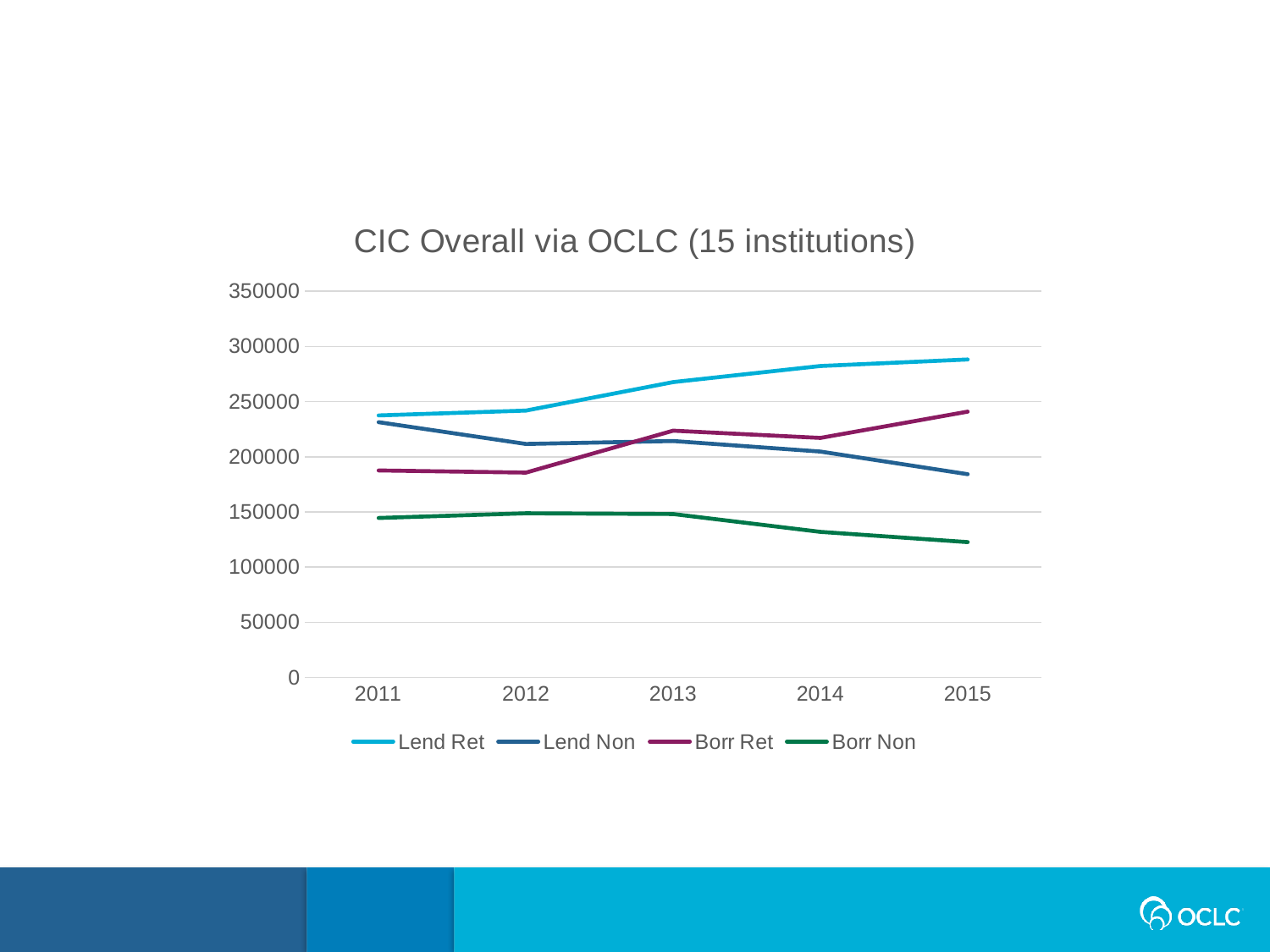
How many series does the legend list? 4 Is the value for Borr Ret in 2011 greater or less than 200000? less Does the Lend Ret series rise or fall from 2011 to 2015? rise What is the title of the chart? CIC Overall via OCLC (15 institutions) Which series has the highest value in 2015? Lend Ret How many years are plotted along the x axis? 5 Is the value for Lend Ret in 2015 greater or less than 250000? greater Is the value for Lend Non in 2011 greater or less than 200000? greater What kind of chart is shown on the slide? line chart Which series has the lowest value in 2015? Borr Non In 2015, which is larger: Borr Ret or Lend Non? Borr Ret